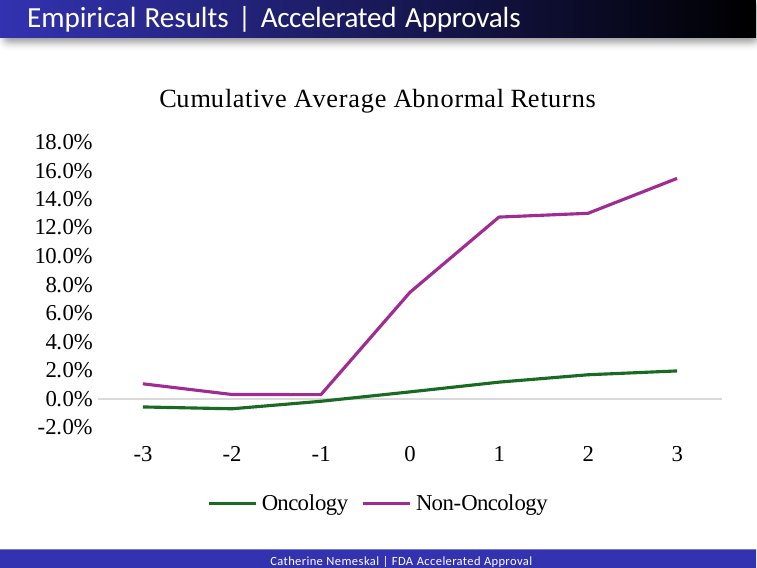
At x = 3, which series has the larger value, Oncology or Non-Oncology? Non-Oncology Is the Oncology value at x = -3 greater or less than 0.0%? less Is the Non-Oncology value at x = -1 greater or less than 2.0%? less Is the Non-Oncology value at x = 0 greater or less than 6.0%? greater At which x value does the Non-Oncology series reach its highest point? 3 How many series does the legend list? 2 Does the Non-Oncology series rise or fall overall from x = -3 to x = 3? rise What is the title of the chart? Cumulative Average Abnormal Returns How many points are plotted along the x axis for each series? 7 What kind of chart is shown on the slide? line chart